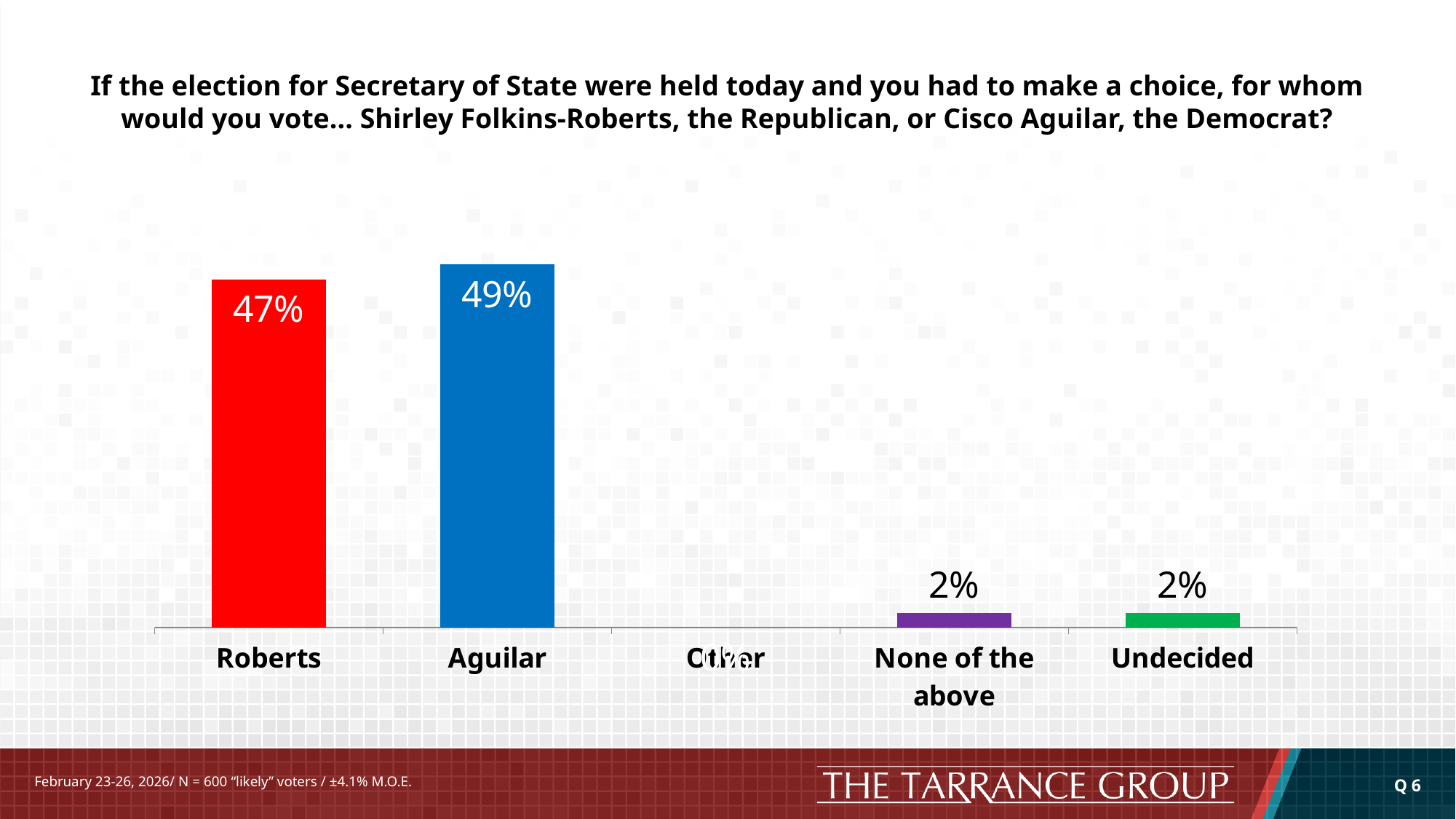
What is the value shown for 'None of the above'? 2% What is the value shown for 'Undecided'? 2% What percentage of respondents said they would vote for Roberts? 47% What colour is the bar for Roberts? Red Which category has the highest value in the chart? Aguilar What kind of chart is shown on the slide? Bar chart How many categories are shown on the x axis of the chart? 5 What percentage of respondents said they would vote for Aguilar? 49% What is the difference in percentage points between Aguilar and Roberts? 2 percentage points What colour is the bar for Aguilar? Blue Which is larger, the value for Roberts or the value for Undecided? Roberts Which is larger, the value for Roberts or the value for Aguilar? Aguilar